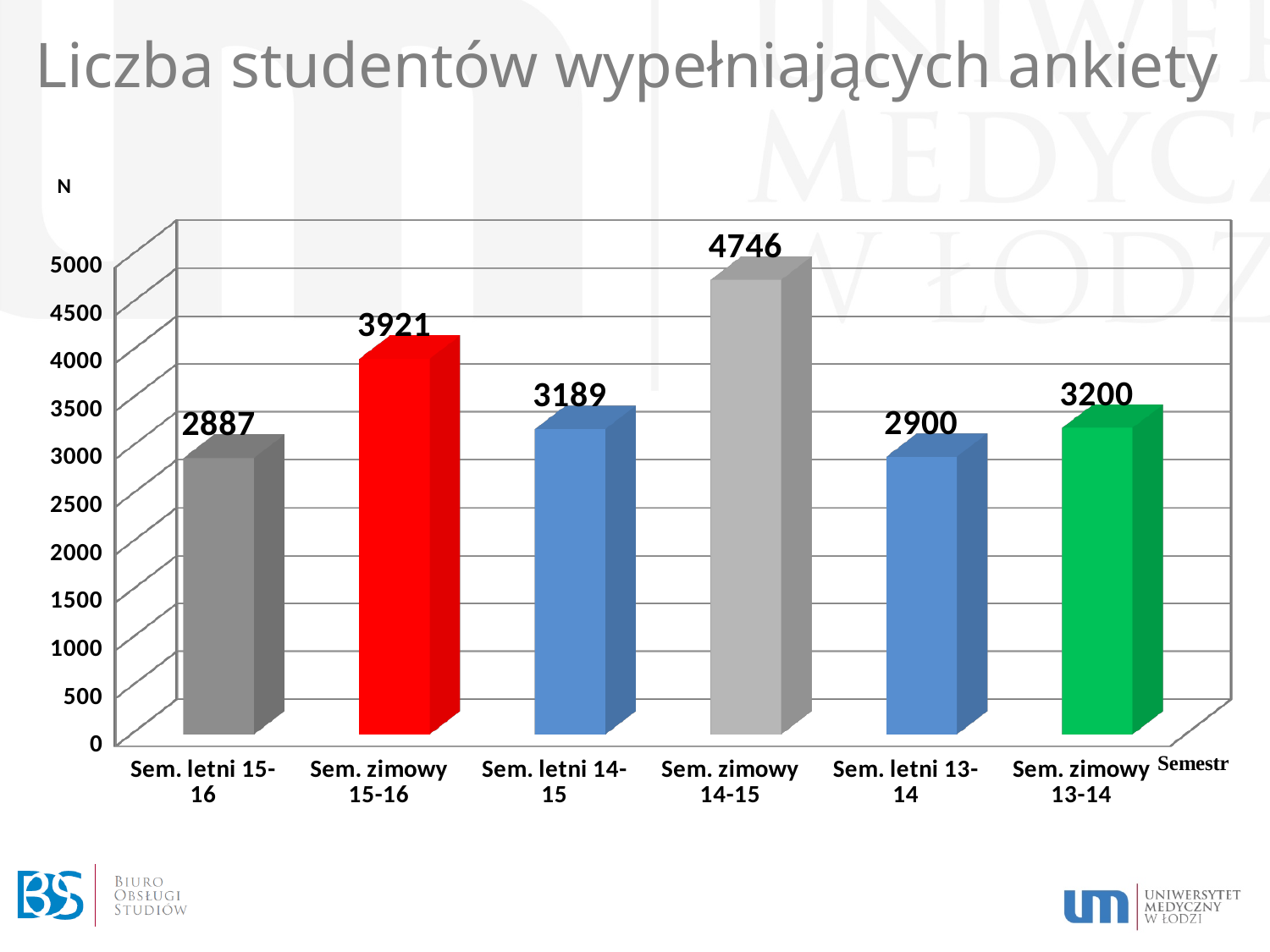
Is the value for Sem. zimowy 14-15 greater or less than 4500? greater What is the value for Sem. zimowy 13-14? 3200 What is the difference between the values for Sem. letni 14-15 and Sem. letni 15-16? 302 How many semesters are shown on the chart? 6 Which semester has the lowest number of students filling in surveys? Sem. letni 15-16 What is the value for Sem. zimowy 15-16? 3921 What is the difference between the values for Sem. zimowy 14-15 and Sem. zimowy 15-16? 825 What is the value for Sem. letni 13-14? 2900 Which is larger, the value for Sem. letni 14-15 or Sem. zimowy 13-14? Sem. zimowy 13-14 What kind of chart is shown on the slide? bar chart What is the title of the chart? Liczba studentów wypełniających ankiety Which semester has the highest number of students filling in surveys? Sem. zimowy 14-15